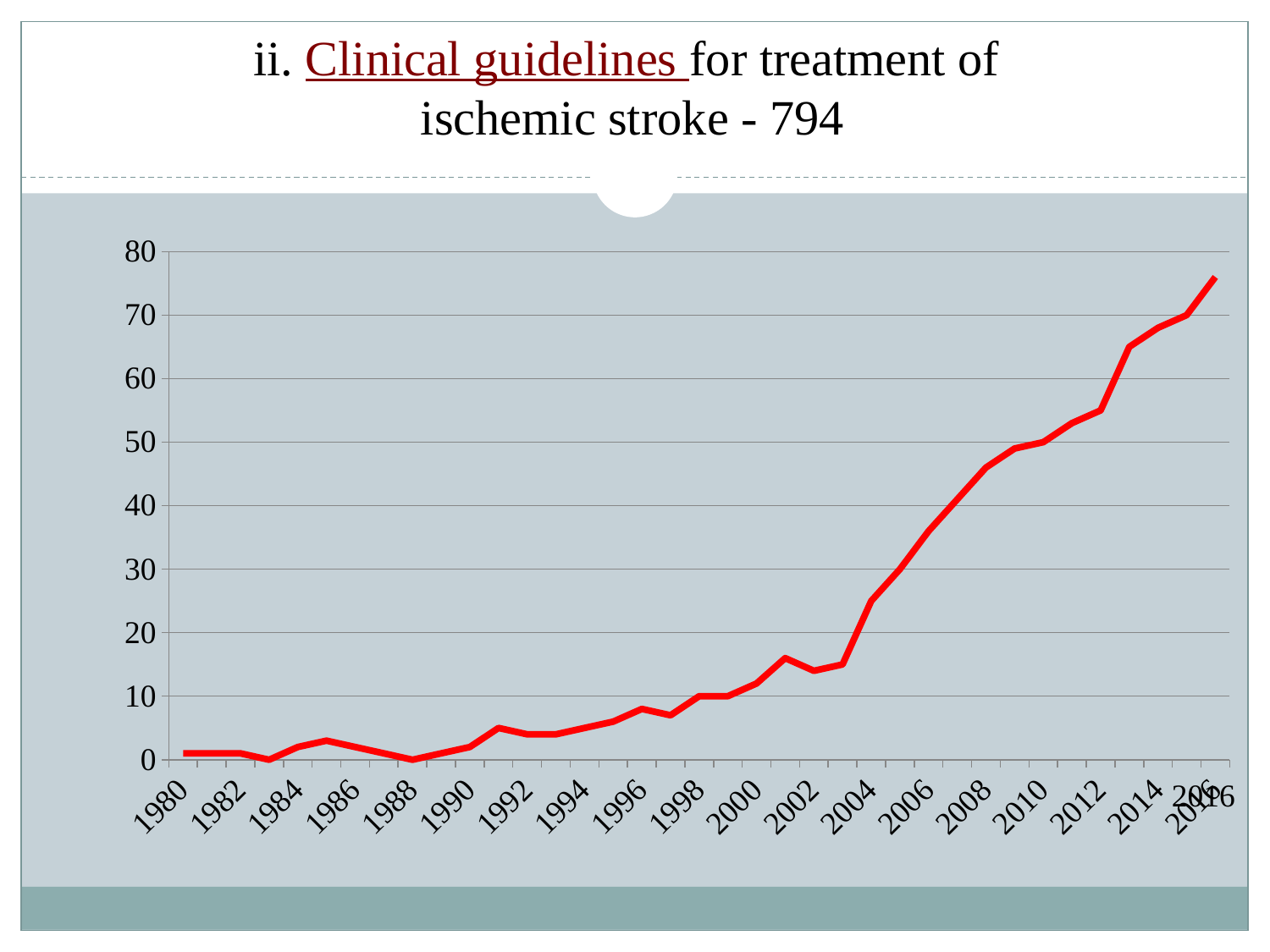
Which year has the larger value, 1980 or 2016? 2016 Which year has the highest value on the chart? 2016 Is the value for 2014 greater or less than 60? greater Which year has the larger value, 2004 or 2000? 2004 Is the value for 2004 greater or less than 20? greater Do the values generally rise or fall from 1980 to 2016? rise What colour is the line plotted on the chart? red Is the value for 2008 greater or less than 50? less What kind of chart is shown on the slide? line chart What is the title of the slide containing the chart? ii. Clinical guidelines for treatment of ischemic stroke - 794